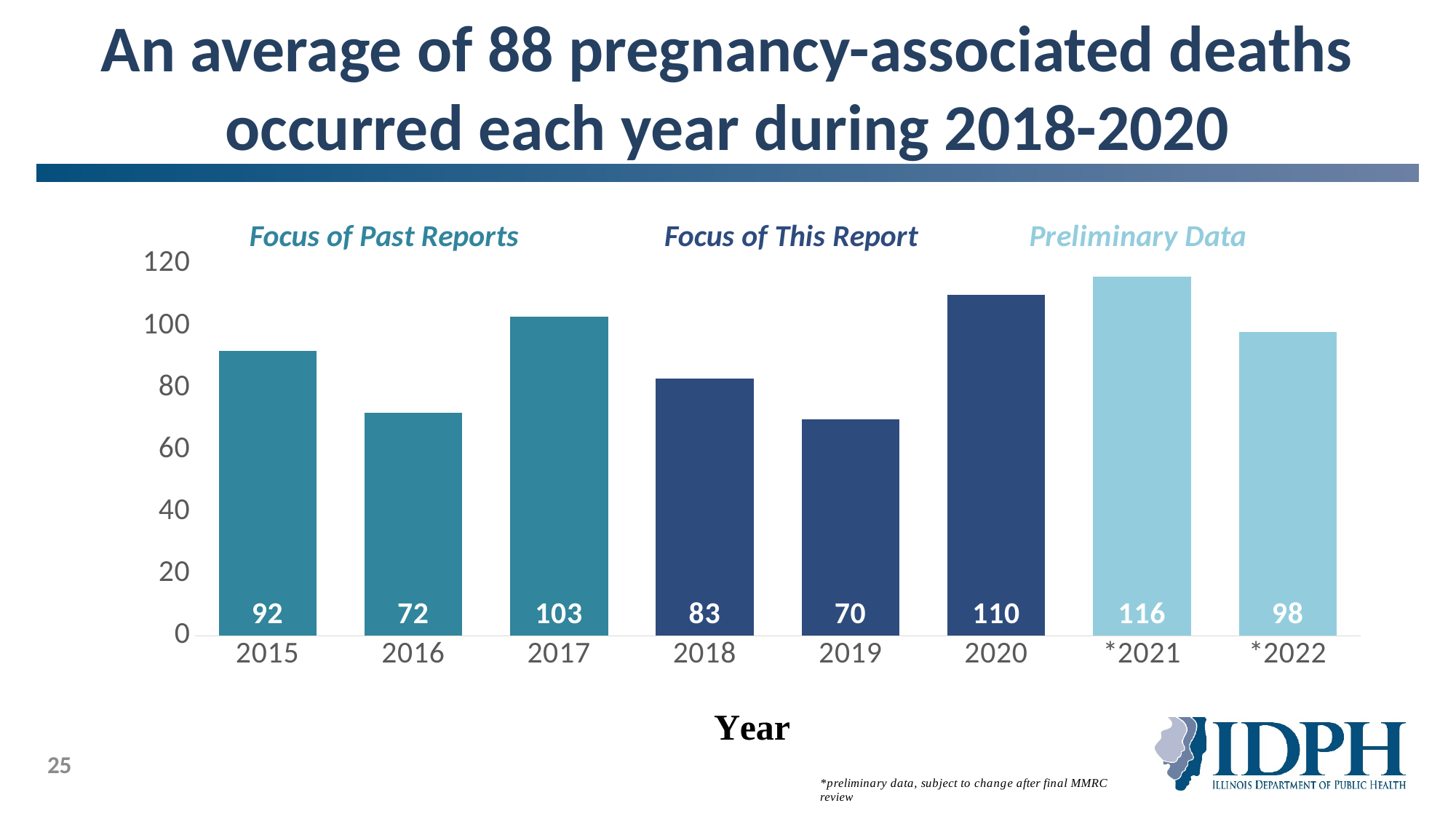
What is the value shown for *2022? 98 What is the value shown for 2019? 70 What is the difference between the values for 2020 and 2018? 27 How many pregnancy-associated deaths occurred in 2017? 103 Which year has the highest number of pregnancy-associated deaths? *2021 Which year has the lowest number of pregnancy-associated deaths? 2019 Which years are labelled as 'Focus of This Report'? 2018, 2019, 2020 Is the value for 2020 greater or less than 100? greater How many years are shown on the x axis? 8 Do the values rise or fall from 2018 to 2019? Fall What kind of chart is shown on the slide? Bar chart Which is larger, the value for 2015 or the value for 2016? 2015